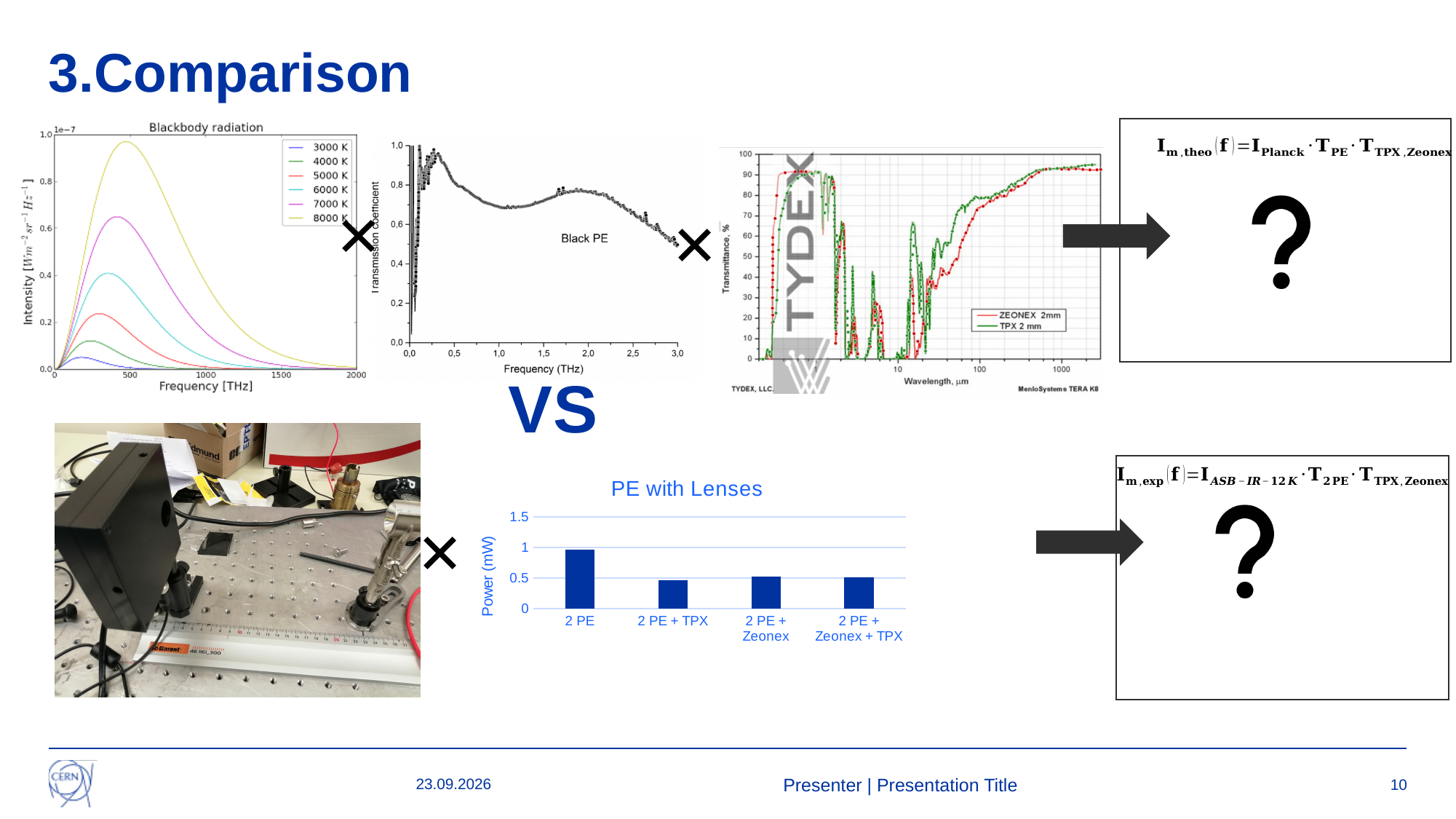
What kind of chart is 'PE with Lenses'? bar chart In the 'Blackbody radiation' chart, which temperature series reaches the highest intensity? 8000 K How many series does the legend of the TYDEX transmittance chart (top right) list? 2 How many series does the legend of the 'Blackbody radiation' chart list? 6 What kind of chart is the 'Blackbody radiation' chart? line chart What is the y-axis label of the TYDEX transmittance chart (top right)? Transmittance, % In the 'PE with Lenses' bar chart, which is larger: the power for 2 PE or for 2 PE + TPX? 2 PE How many categories are shown in the 'PE with Lenses' bar chart? 4 What is the y-axis label of the 'PE with Lenses' chart? Power (mW) In the 'PE with Lenses' bar chart, is the value for 2 PE greater or less than 0.5 mW? greater In the 'PE with Lenses' bar chart, is the value for 2 PE + TPX greater or less than 1 mW? less In the 'PE with Lenses' bar chart, which category has the highest power? 2 PE